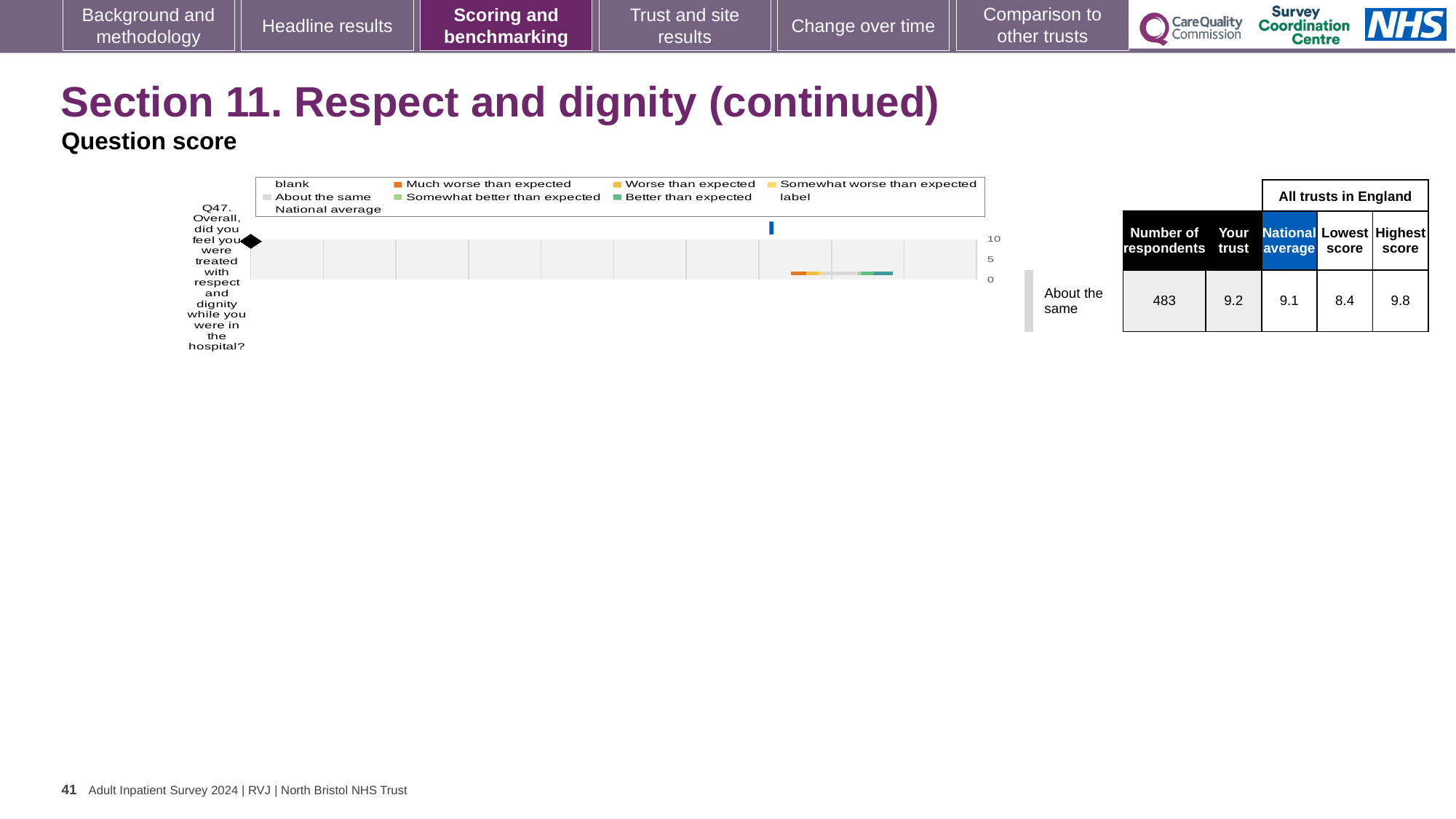
Which question number is plotted in the chart? Q47 What is the difference between the highest score and the lowest score for Q47? 1.4 What is the difference between the 'Your trust' score and the national average for Q47? 0.1 What is the highest score among all trusts in England for Q47? 9.8 What is the national average score for Q47? 9.1 What kind of chart is shown on the slide? bar chart Which benchmarking category is Q47 assigned to? About the same Which is larger for Q47, the 'Your trust' score or the national average? Your trust How many respondents answered Q47? 483 How many survey questions are plotted in the chart? 1 What is the lowest score among all trusts in England for Q47? 8.4 What is the 'Your trust' score for Q47? 9.2